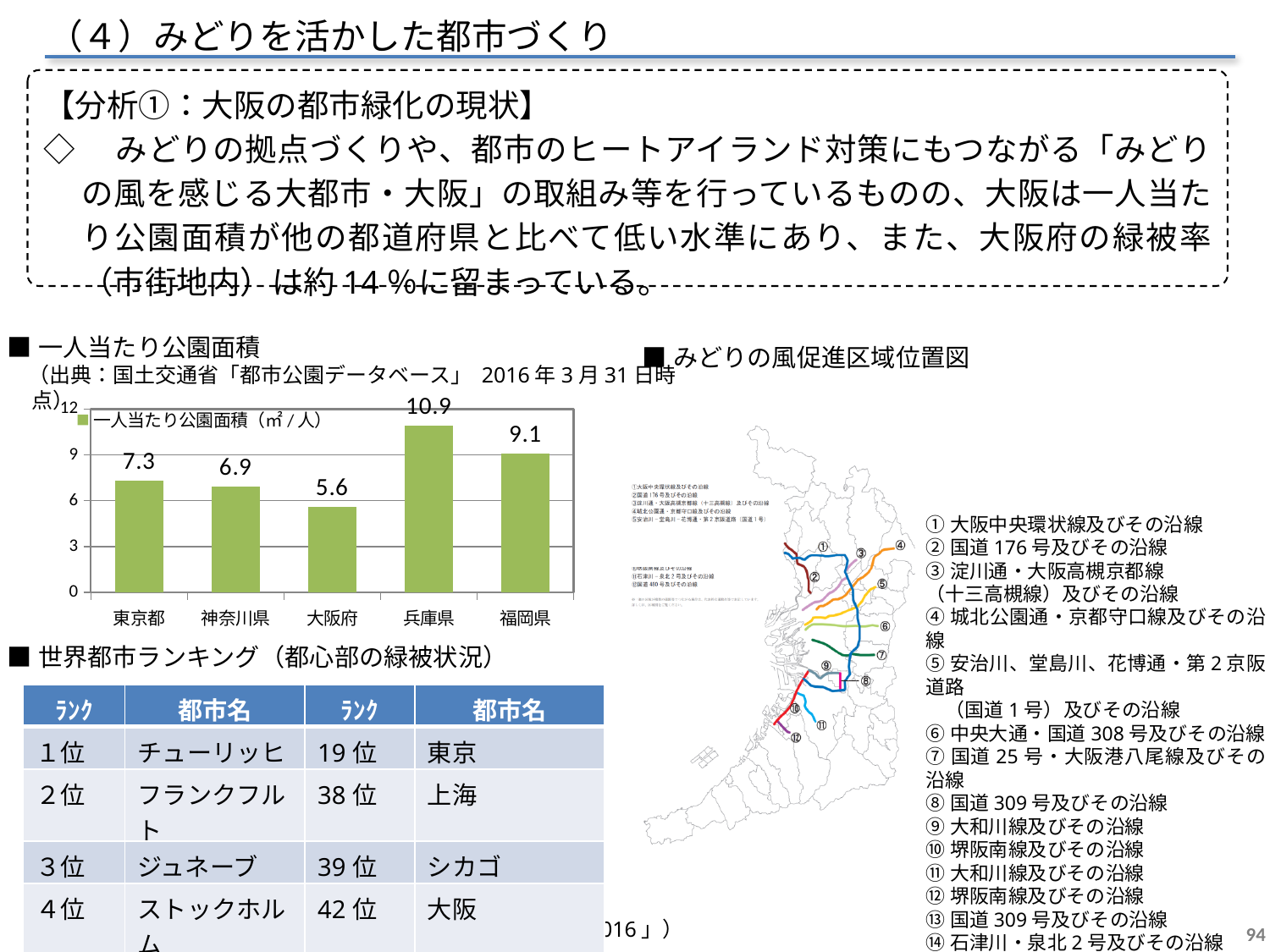
In the 一人当たり公園面積 chart, what is the difference between the values for 兵庫県 and 大阪府? 5.3 What is the value for 東京都 in the 一人当たり公園面積 chart? 7.3 Which prefecture has the lowest value in the 一人当たり公園面積 chart? 大阪府 What is the value for 大阪府 in the 一人当たり公園面積 chart? 5.6 In the 一人当たり公園面積 chart, which is larger, the value for 東京都 or 神奈川県? 東京都 Which prefecture has the highest value in the 一人当たり公園面積 chart? 兵庫県 How many prefectures are shown in the 一人当たり公園面積 chart? 5 What is the value for 兵庫県 in the 一人当たり公園面積 chart? 10.9 In the 一人当たり公園面積 chart, is the value for 福岡県 greater or less than 6? greater What kind of chart is the 一人当たり公園面積 chart? bar chart What is the value for 福岡県 in the 一人当たり公園面積 chart? 9.1 What is the legend entry shown in the 一人当たり公園面積 chart? 一人当たり公園面積（㎡/人）